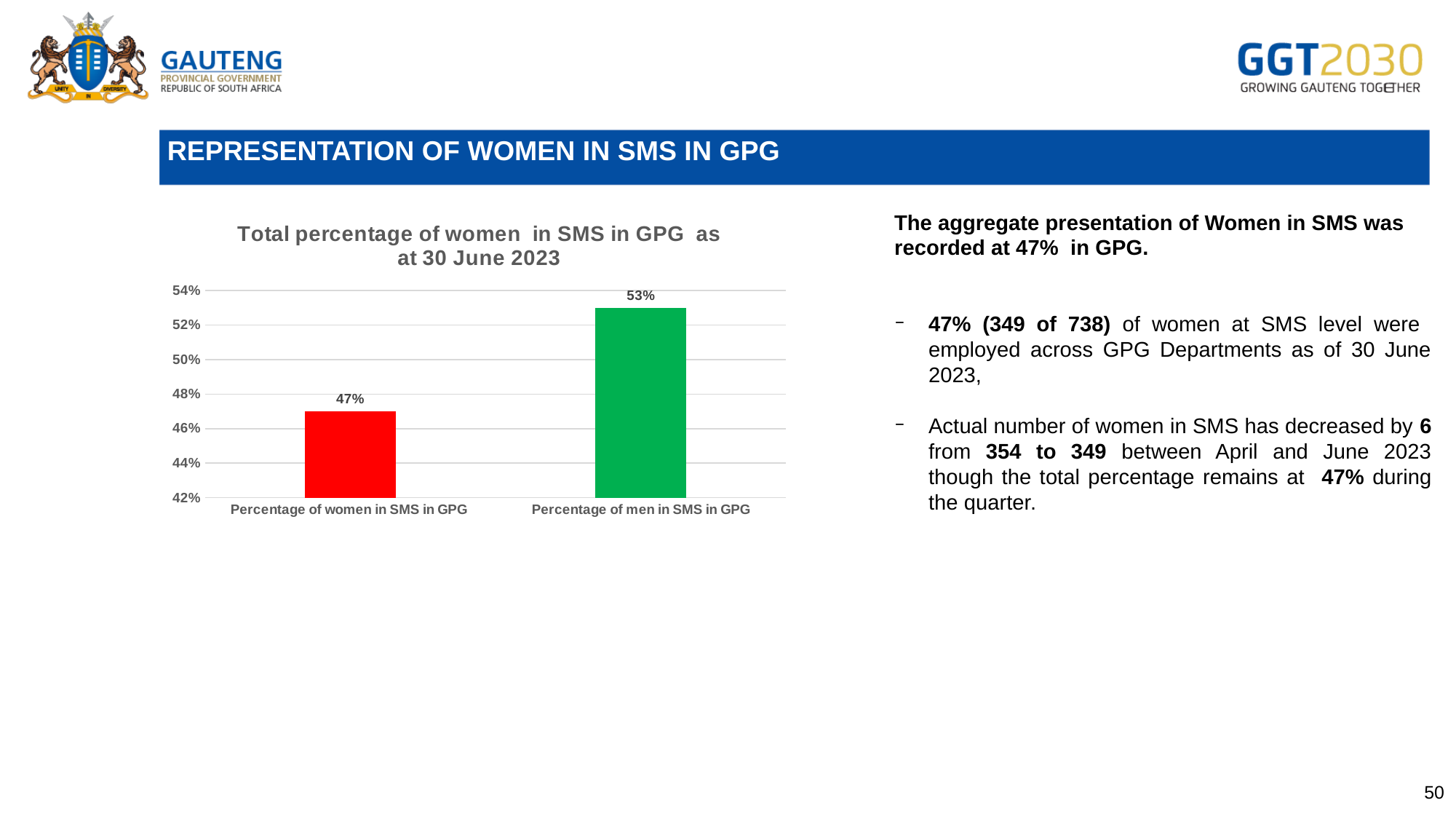
How many categories are shown in the chart? 2 What kind of chart is shown on the slide? Bar chart What colour is the bar for Percentage of women in SMS in GPG? Red Which category has the highest value? Percentage of men in SMS in GPG Which category has the lowest value? Percentage of women in SMS in GPG Is the value for Percentage of women in SMS in GPG greater or less than 50%? less Which is larger, the percentage of women in SMS in GPG or the percentage of men in SMS in GPG? Percentage of men in SMS in GPG What is the difference between the percentage of men and the percentage of women in SMS in GPG? 6% What is the value for Percentage of men in SMS in GPG? 53% What is the title of the chart? Total percentage of women in SMS in GPG as at 30 June 2023 Is the value for Percentage of men in SMS in GPG greater or less than 50%? greater What is the value for Percentage of women in SMS in GPG? 47%